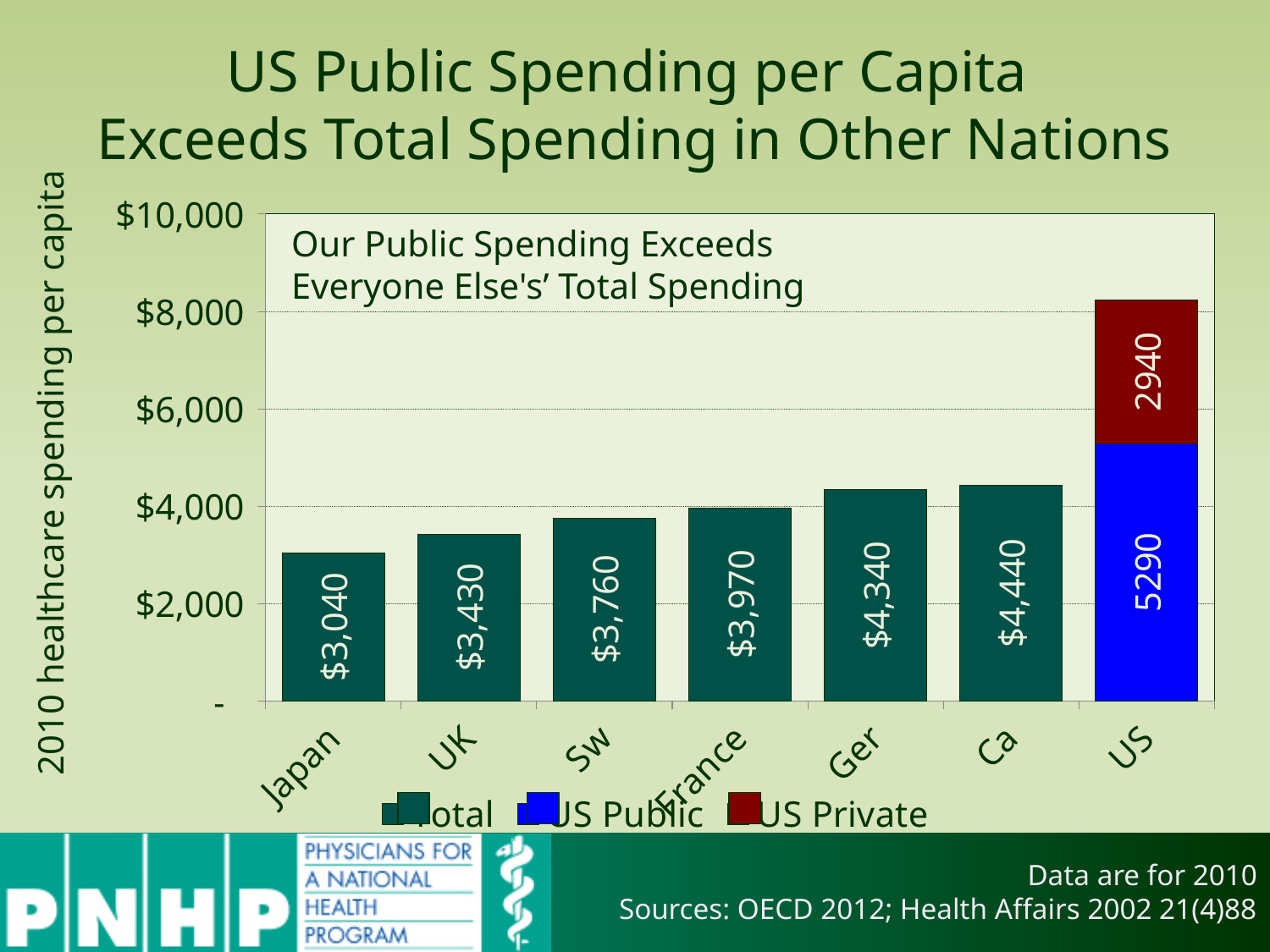
How many countries are shown on the x axis? 7 How many series does the legend list? 3 What is the US Private spending per capita shown on the US bar? 2940 Which country has the highest total healthcare spending per capita? US What is the US Public spending per capita shown on the US bar? 5290 Which has higher total spending per capita, France or Sweden (Sw)? France What is the total healthcare spending per capita for Japan? $3,040 Which country has the lowest total healthcare spending per capita? Japan What is the total of the stacked US bar (US Public plus US Private)? 8230 What type of chart is shown on the slide? Bar chart What is the total healthcare spending per capita for Germany (Ger)? $4,340 What is the difference between the total spending per capita for Canada (Ca) and the UK? $1,010